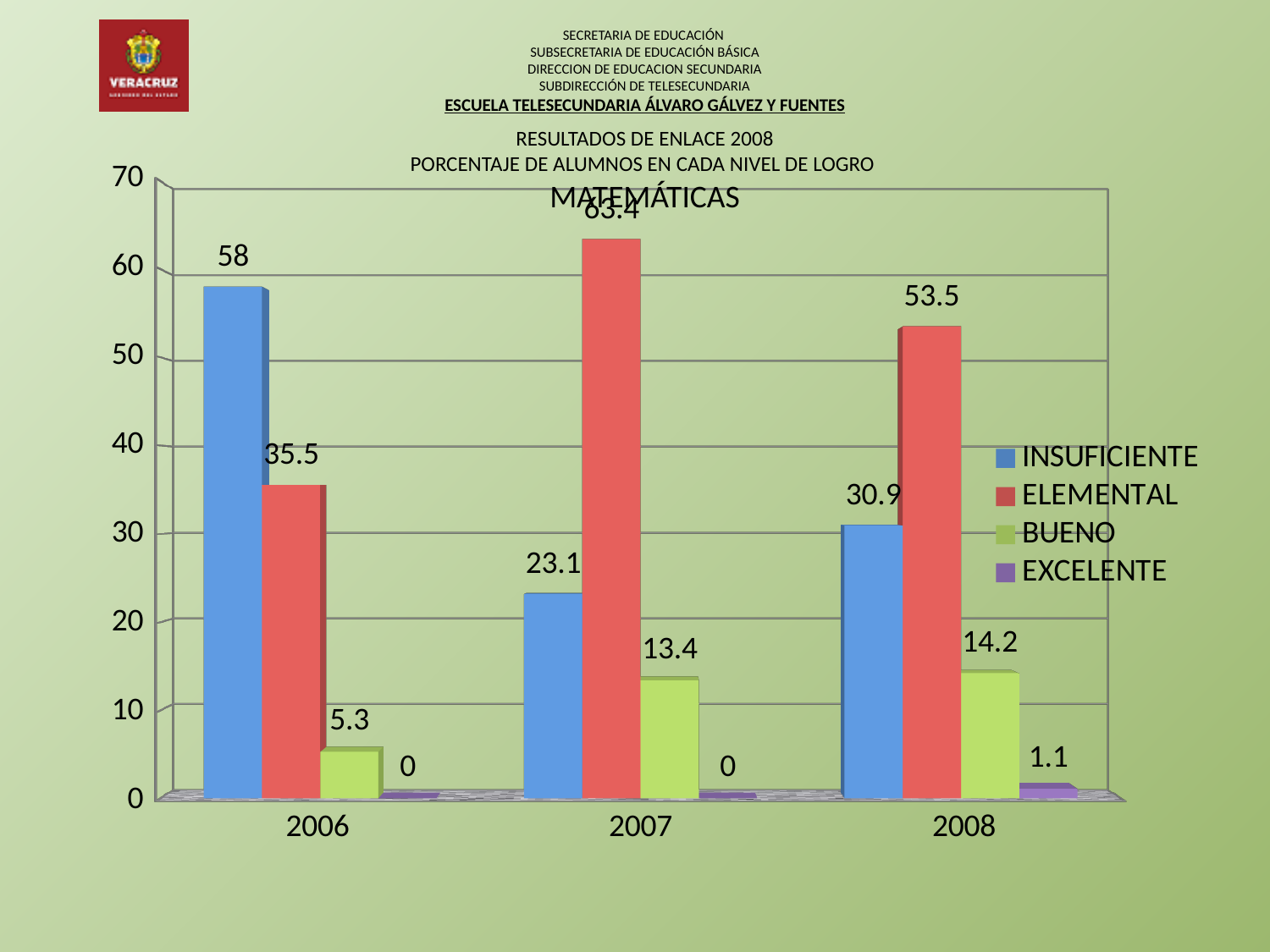
What is the value for BUENO in 2008? 14.2 In which year is the INSUFICIENTE value lowest? 2007 What kind of chart is shown? bar chart In which year is the ELEMENTAL value highest? 2007 What is the value for ELEMENTAL in 2007? 63.4 Does the BUENO value rise or fall from 2006 to 2008? rise What is the value for INSUFICIENTE in 2006? 58 How many series does the legend list? 4 What is the difference between the ELEMENTAL values for 2007 and 2008? 9.9 What is the value for EXCELENTE in 2008? 1.1 Which is larger, the INSUFICIENTE value in 2008 or the ELEMENTAL value in 2006? ELEMENTAL in 2006 How many years are shown on the x axis? 3